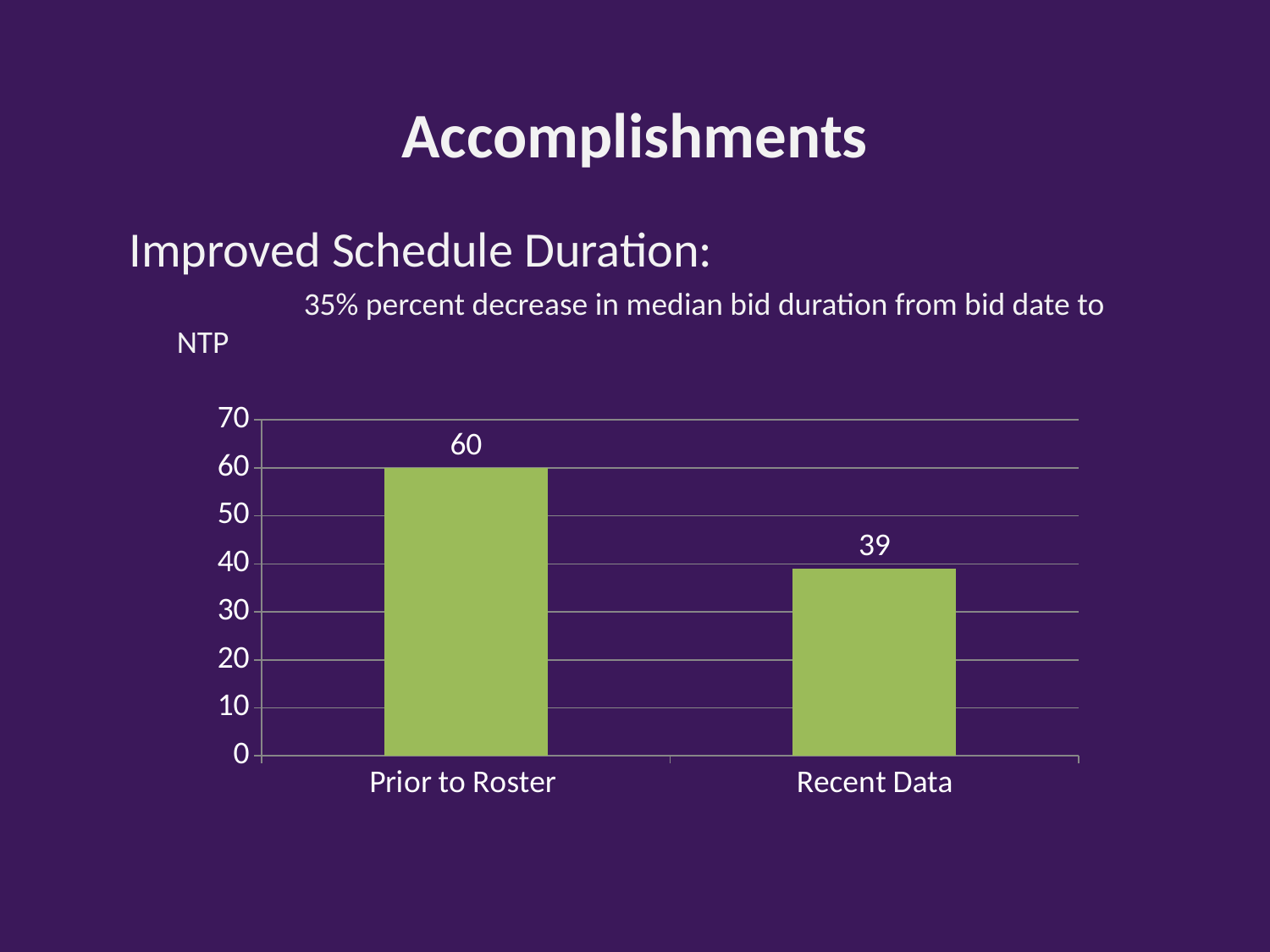
What is the value for Prior to Roster? 60 Which category has the highest value? Prior to Roster How many categories are shown on the x axis? 2 What is the difference between the values for Prior to Roster and Recent Data? 21 Do the values rise or fall from Prior to Roster to Recent Data? fall Which is larger, the value for Prior to Roster or the value for Recent Data? Prior to Roster Is the value for Recent Data greater or less than 50? less What kind of chart is shown on the slide? bar chart Is the value for Prior to Roster greater or less than 50? greater Which category has the lowest value? Recent Data What is the value for Recent Data? 39 What is the highest value shown on the vertical axis? 70